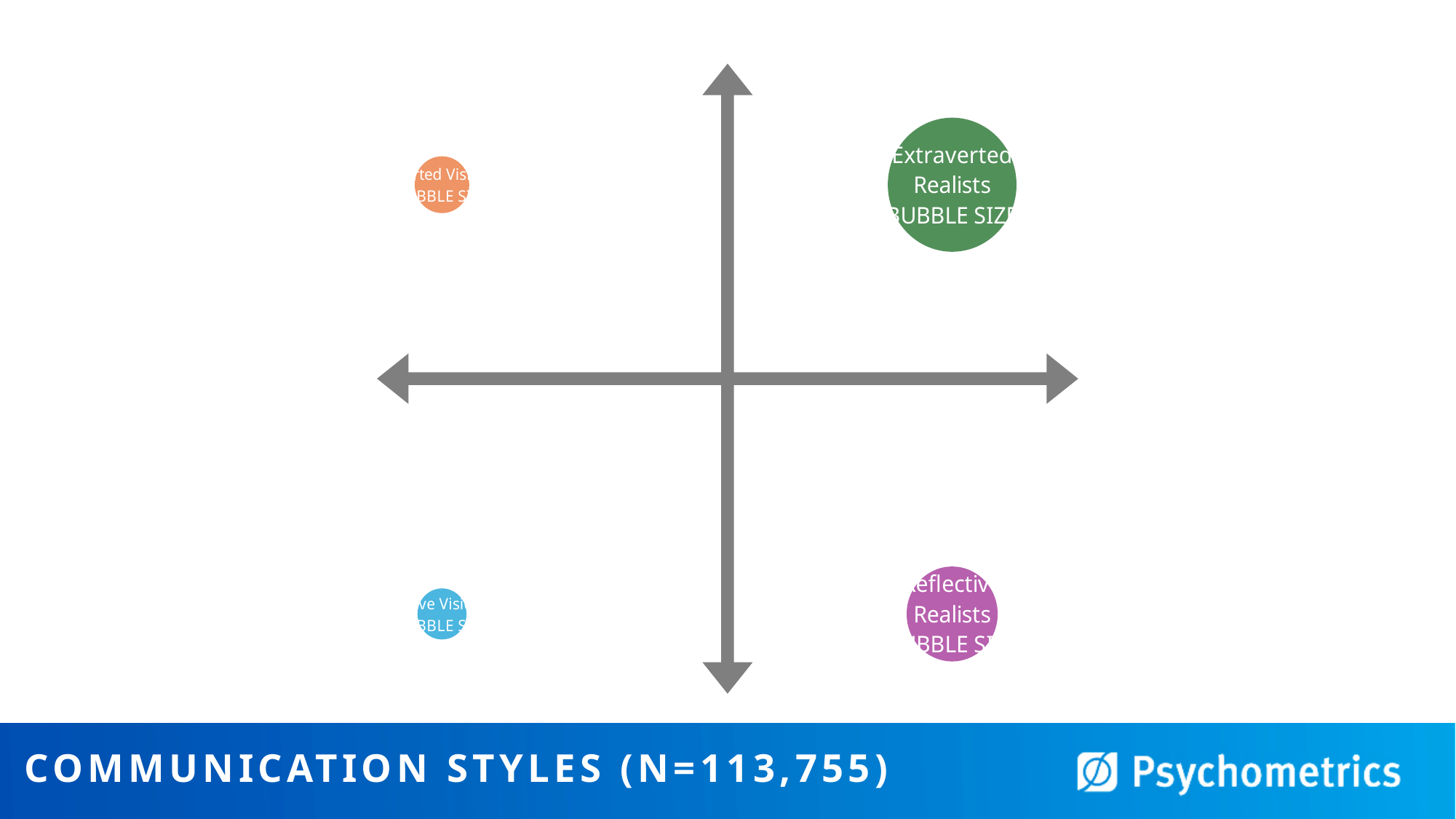
How many bubbles are plotted on the chart? 4 What is the title shown at the bottom of the slide? COMMUNICATION STYLES (N=113,755) What kind of chart is shown on the slide? bubble chart Which bubble is larger, Extraverted Realists or Reflective Realists? Extraverted Realists What colour is the Extraverted Realists bubble? green Which bubble on the chart is the largest? Extraverted Realists